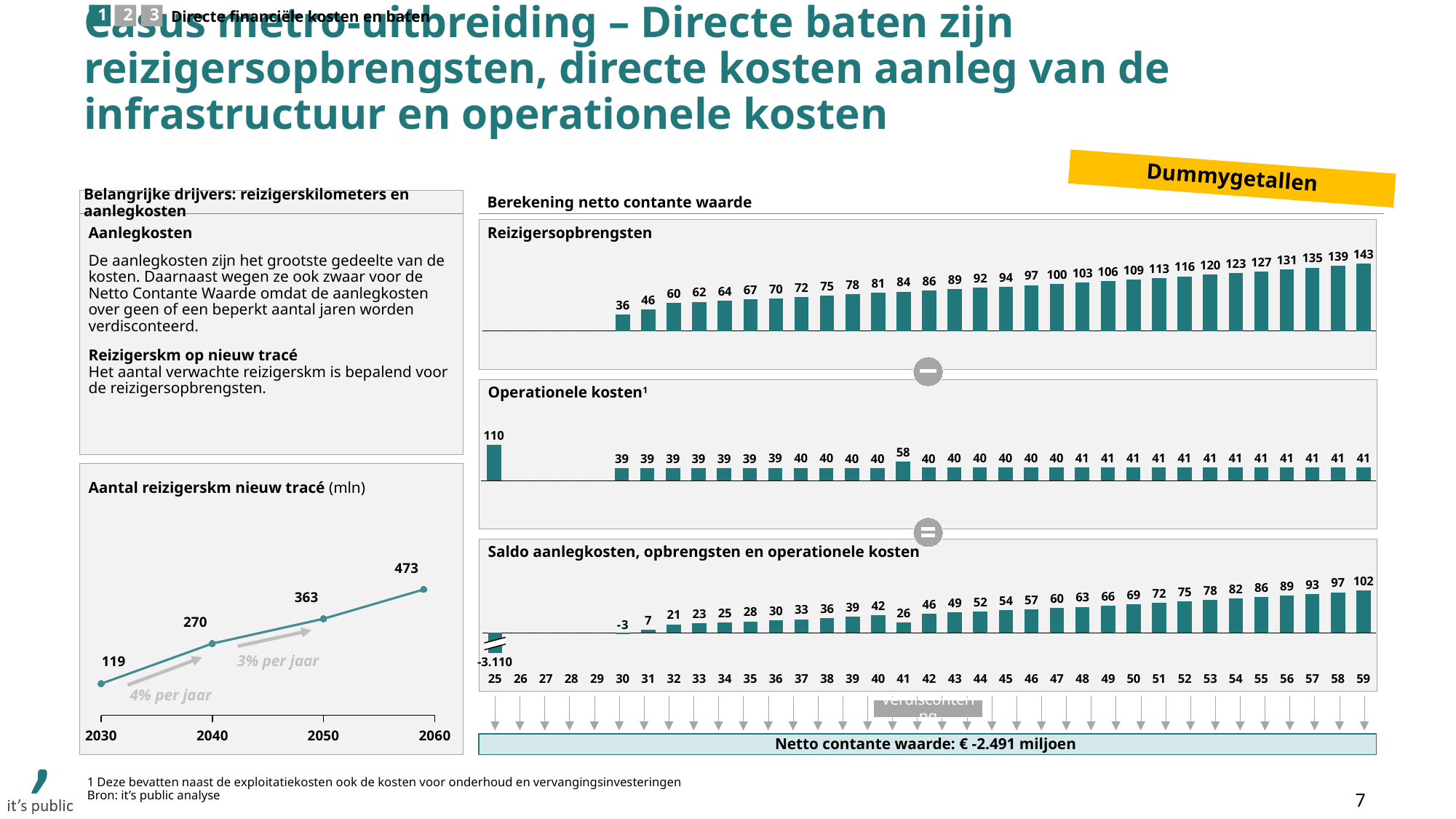
In the 'Operationele kosten' chart, what is the value of the first bar after the 110 bar? 39 In the 'Aantal reizigerskm nieuw tracé (mln)' chart, what is the value for 2060? 473 In the 'Reizigersopbrengsten' chart, what is the value of the lowest bar? 36 In the 'Aantal reizigerskm nieuw tracé (mln)' chart, how many data points are plotted? 4 In the 'Aantal reizigerskm nieuw tracé (mln)' chart, what is the value for 2040? 270 In the 'Saldo aanlegkosten, opbrengsten en operationele kosten' chart, what is the value for year 59? 102 In the 'Operationele kosten' chart, what is the value of the highest bar? 110 In the 'Reizigersopbrengsten' chart, what is the value of the highest bar? 143 In the 'Aantal reizigerskm nieuw tracé (mln)' chart, do the values rise or fall from 2030 to 2060? rise What kind of chart is 'Aantal reizigerskm nieuw tracé (mln)'? line chart In the 'Aantal reizigerskm nieuw tracé (mln)' chart, what is the difference between the 2050 and 2030 values? 244 In the 'Saldo aanlegkosten, opbrengsten en operationele kosten' chart, what is the value for year 25? -3.110